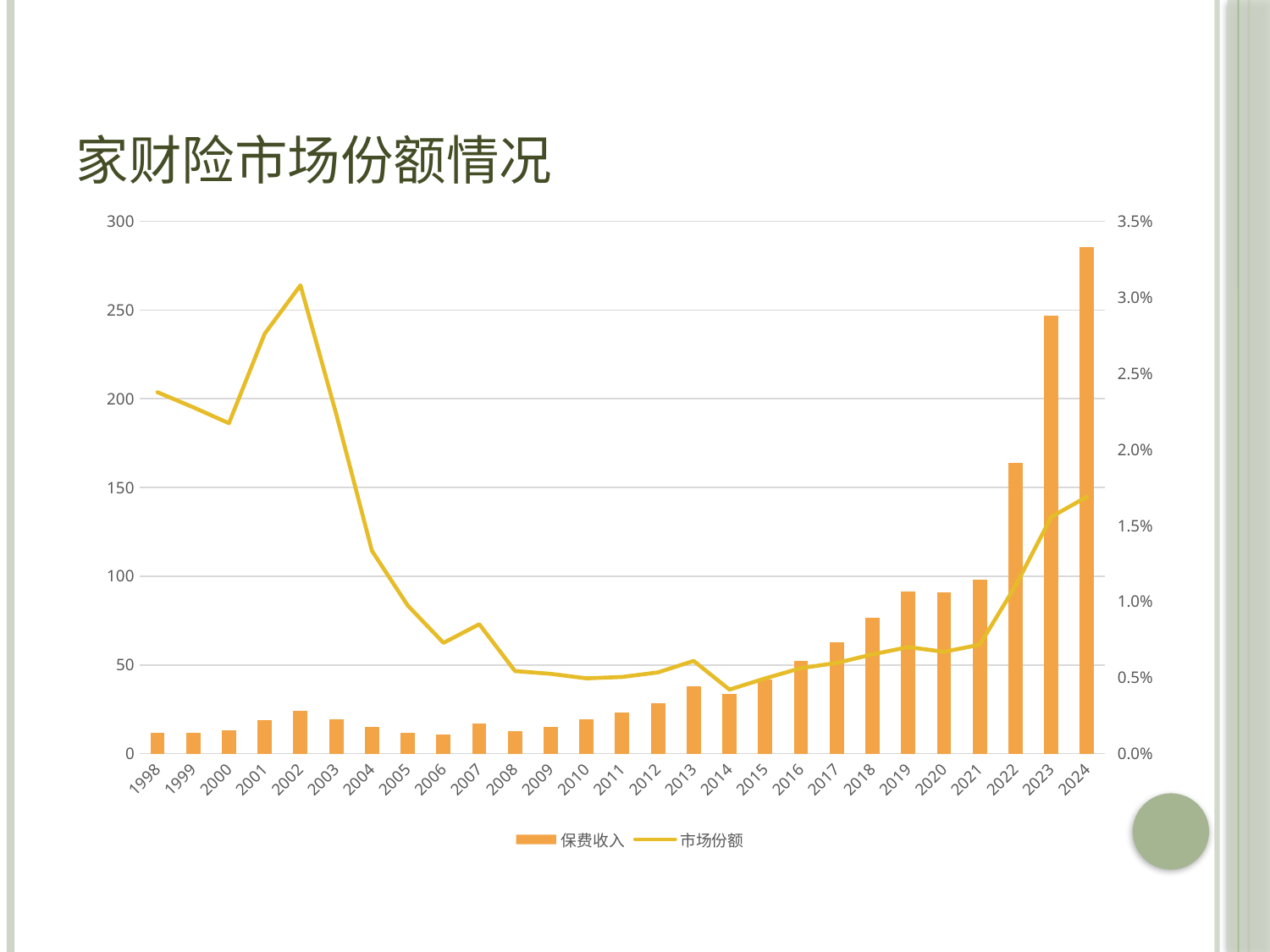
What are the two series named in the legend? 保费收入 and 市场份额 In which year does the 市场份额 line reach its highest point? 2002 Which year has the highest 保费收入 bar? 2024 Is the 保费收入 value for 2022 greater or less than 150? greater Which year has the larger 保费收入 bar, 2021 or 2022? 2022 What kind of chart is shown on the slide? A combined bar and line chart How many series does the legend list? 2 How many years are shown along the x axis? 27 Does the 市场份额 line rise or fall from 2002 to 2008? fall Is the 市场份额 value for 2002 greater or less than 3.0%? greater In which year does the 市场份额 line reach its lowest point? 2014 Is the 保费收入 value for 2024 greater or less than 250? greater